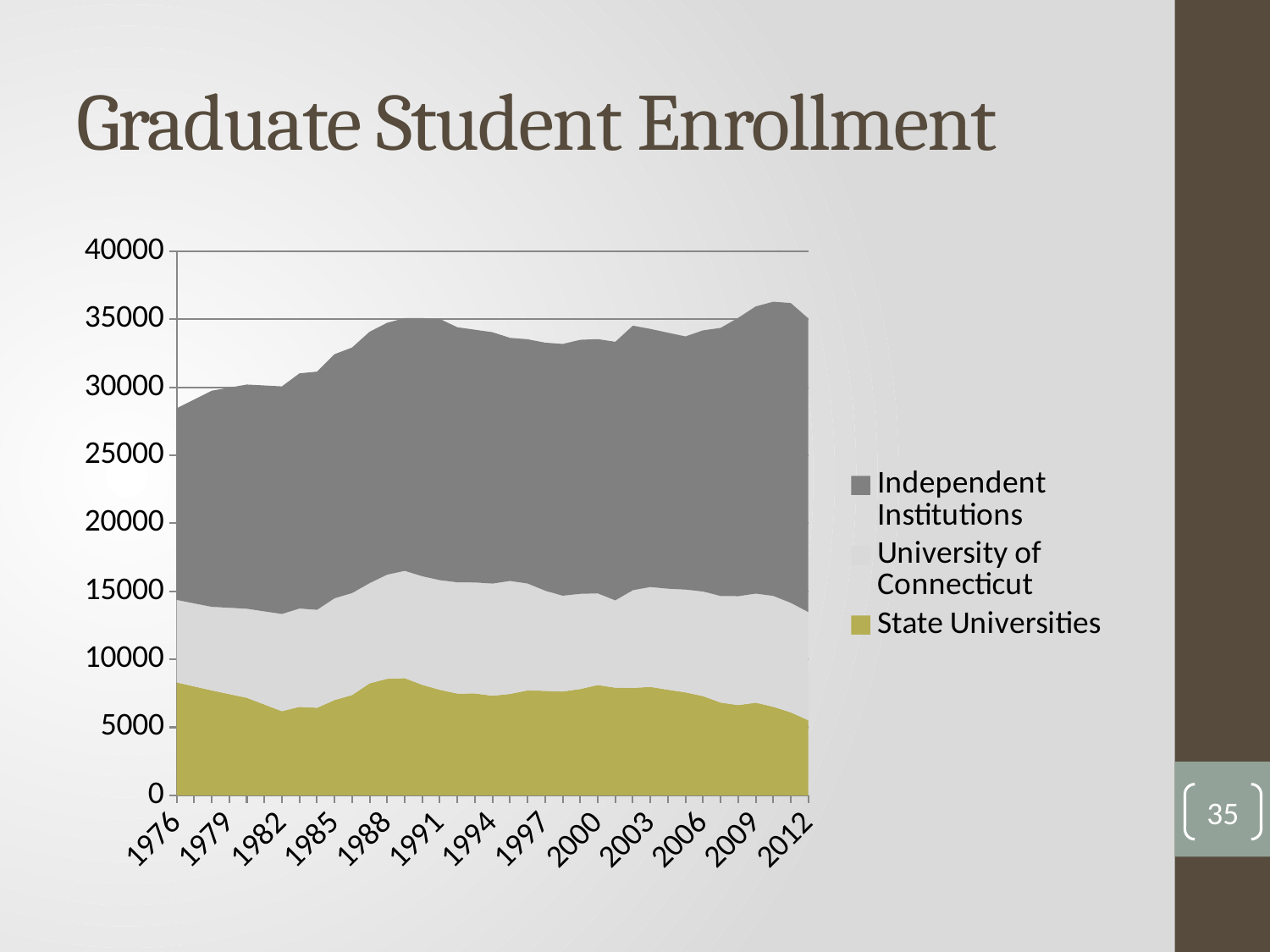
Is the value for State Universities in 1976 greater or less than 5000? greater Is the total enrollment across all three series in 1976 greater or less than 30000? less Which series has the largest enrollment in 1976? Independent Institutions What kind of chart is shown on the slide? Stacked area chart How many year labels are shown on the x axis? 13 Does the total enrollment rise or fall from 1976 to 1988? Rise Does the State Universities enrollment rise or fall from 2003 to 2012? Fall How many series does the legend list? 3 Is the value for State Universities in 2012 greater or less than 10000? less What is the title of the slide containing the chart? Graduate Student Enrollment Which series is shown in the olive/gold colour at the bottom of the stack? State Universities